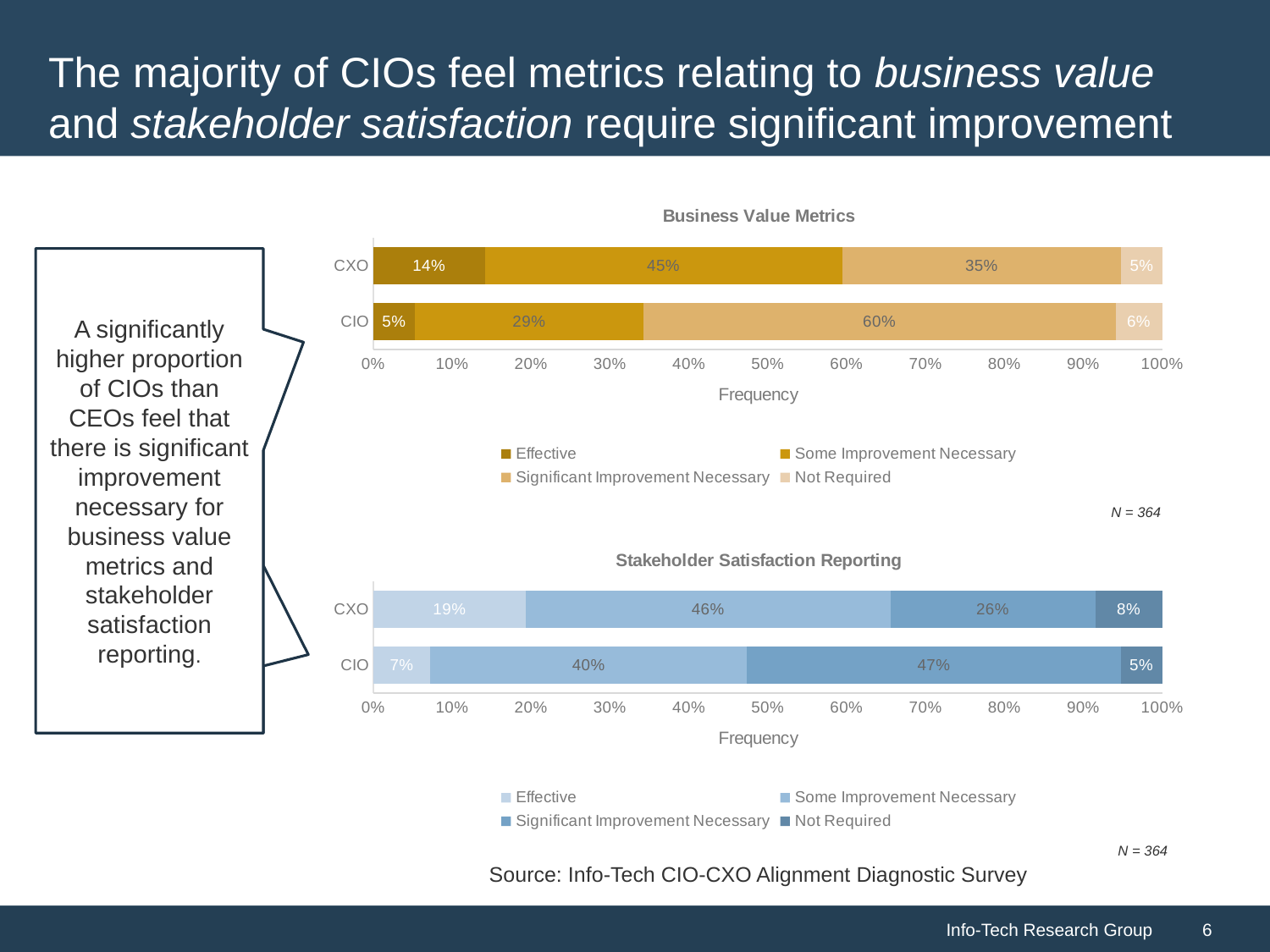
In the Business Value Metrics chart, what percentage of CXOs said Effective? 14% In the Stakeholder Satisfaction Reporting chart, which response category has the smallest share for CIOs? Not Required In the Stakeholder Satisfaction Reporting chart, what percentage of CIOs said Significant Improvement Necessary? 47% In the Business Value Metrics chart, which response category has the largest share for CXOs? Some Improvement Necessary In the Stakeholder Satisfaction Reporting chart, which group has a larger Effective share, CXO or CIO? CXO How many categories (groups) are shown on the y axis of the Stakeholder Satisfaction Reporting chart? 2 What type of chart is the Stakeholder Satisfaction Reporting chart? Stacked bar chart How many series does the legend of the Business Value Metrics chart list? 4 In the Business Value Metrics chart, what percentage of CIOs said Significant Improvement Necessary? 60% In the Stakeholder Satisfaction Reporting chart, what percentage of CXOs said Some Improvement Necessary? 46% What is the x-axis label on the Business Value Metrics chart? Frequency In the Business Value Metrics chart, what is the difference between the CIO and CXO percentages for Significant Improvement Necessary? 25%